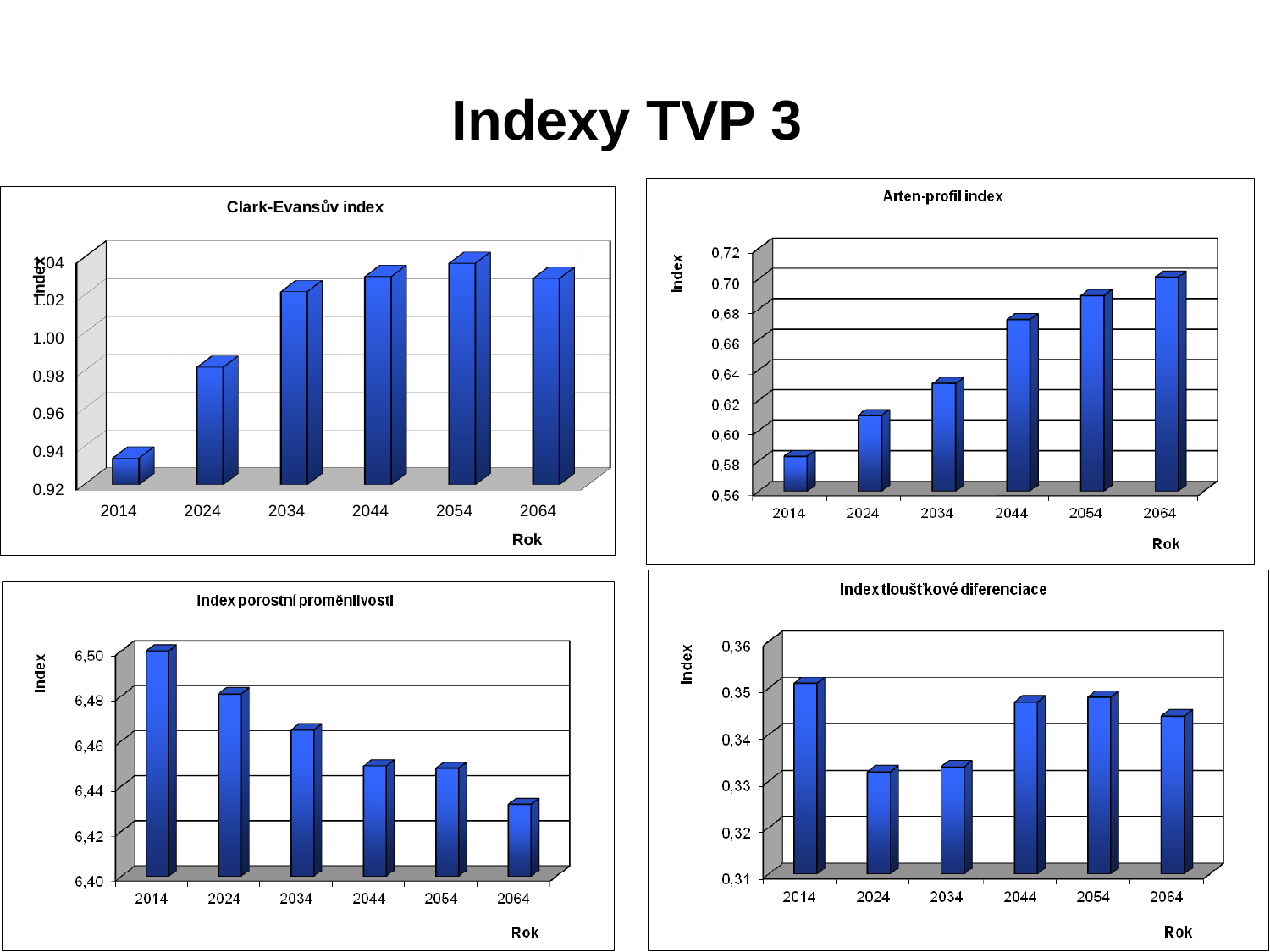
In the Clark-Evansův index chart, is the value for 2024 greater or less than 1.00? less In the Index porostní proměnlivosti chart, do the values rise or fall from 2014 to 2064? fall In the Arten-profil index chart, is the value for 2044 greater or less than 0,66? greater In the Index tloušťkové diferenciace chart, which year has the highest value? 2014 In the Arten-profil index chart, which is larger, the value for 2024 or the value for 2054? 2054 In the Index tloušťkové diferenciace chart, is the value for 2024 greater or less than 0,34? less How many years are shown on the x axis of the Clark-Evansův index chart? 6 In the Index porostní proměnlivosti chart, which year has the highest value? 2014 In the Arten-profil index chart, which year has the highest value? 2064 In the Clark-Evansův index chart, do the values generally rise or fall from 2014 to 2064? rise In the Clark-Evansův index chart, which year has the lowest value? 2014